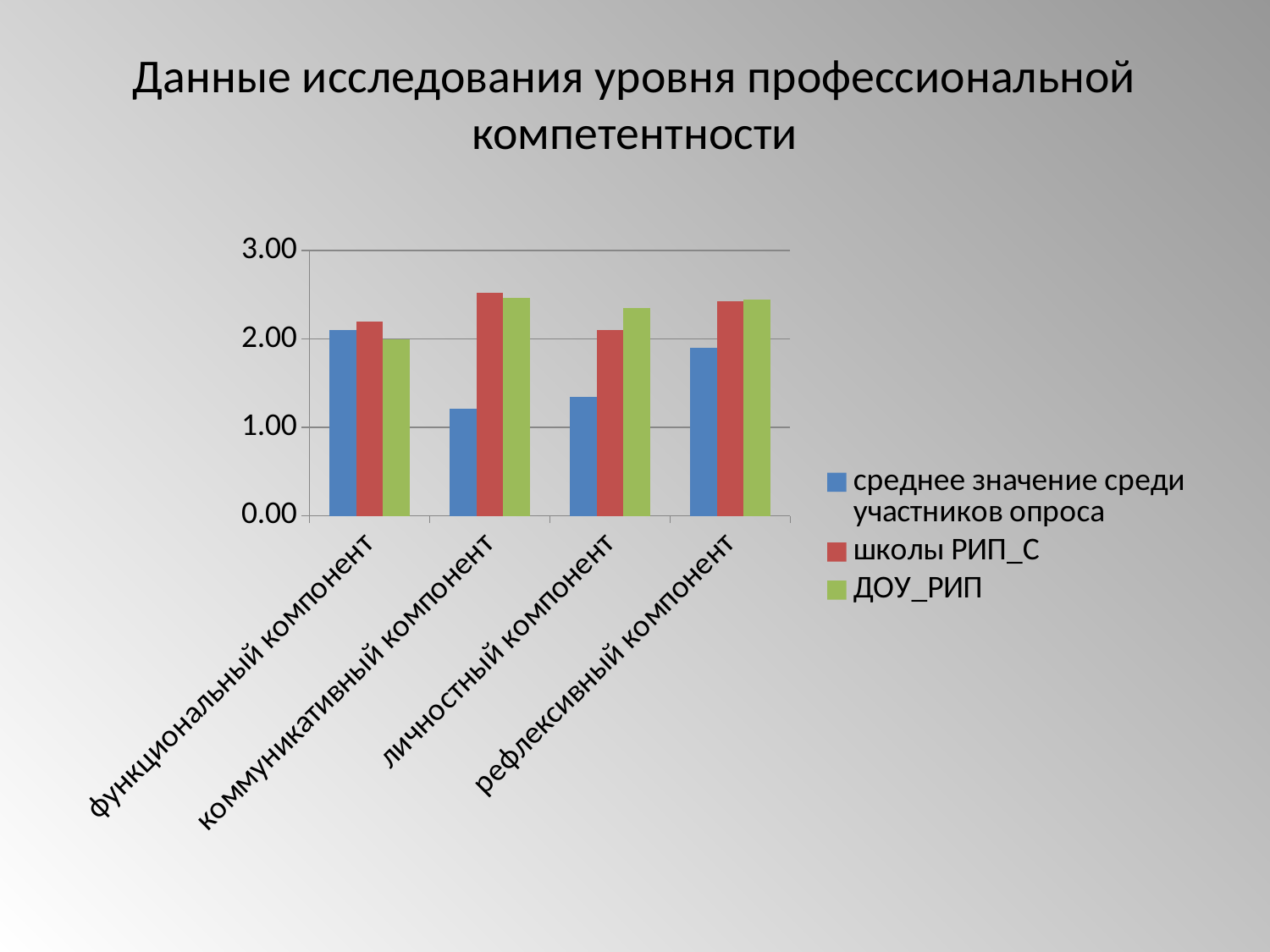
For the series 'среднее значение среди участников опроса', which category has the lowest value? коммуникативный компонент For the series 'среднее значение среди участников опроса', which category has the highest value? функциональный компонент Is the value for 'ДОУ_РИП' in 'личностный компонент' greater or less than 2.00? greater How many categories are shown on the x axis of the chart? 4 In 'коммуникативный компонент', which is larger: 'среднее значение среди участников опроса' or 'школы РИП_С'? школы РИП_С How many series does the legend list? 3 For the series 'ДОУ_РИП', which category has the lowest value? функциональный компонент What is the title of the slide? Данные исследования уровня профессиональной компетентности What kind of chart is shown on the slide? bar chart Is the value for 'среднее значение среди участников опроса' in 'личностный компонент' greater or less than 2.00? less Is the value for 'среднее значение среди участников опроса' in 'коммуникативный компонент' greater or less than 2.00? less